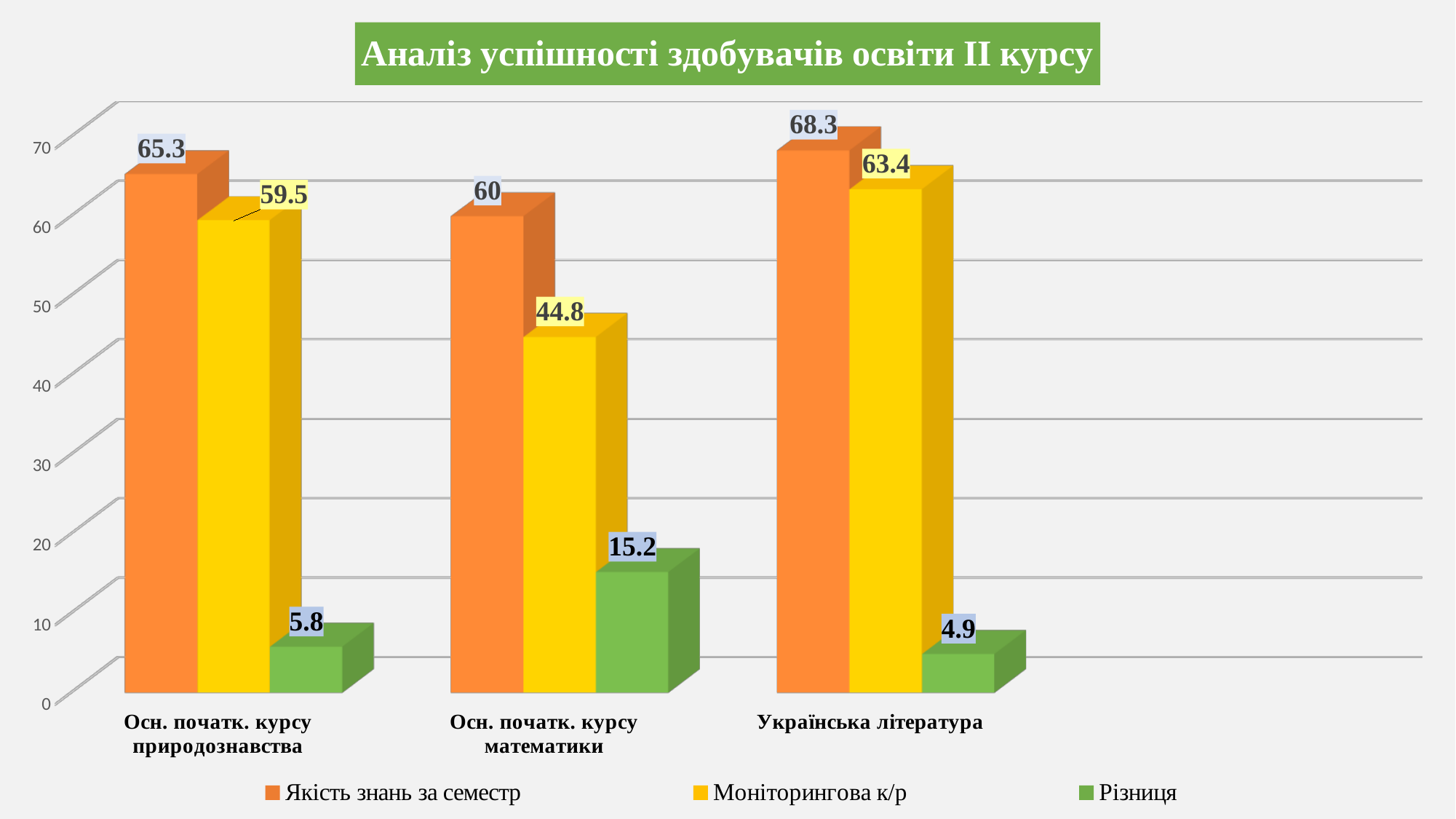
Is the value of "Різниця" for "Осн. початк. курсу математики" greater or less than 10? greater What is the value of "Якість знань за семестр" for "Українська література"? 68.3 Which category has the lowest value for "Моніторингова к/р"? Осн. початк. курсу математики What is the difference between "Якість знань за семестр" and "Моніторингова к/р" for "Осн. початк. курсу математики"? 15.2 What is the value of "Моніторингова к/р" for "Осн. початк. курсу математики"? 44.8 How many categories are shown on the x axis? 3 What is the title of the chart? Аналіз успішності здобувачів освіти ІІ курсу Which category has the highest value for "Якість знань за семестр"? Українська література Which is larger: "Моніторингова к/р" for "Осн. початк. курсу природознавства" or for "Українська література"? Українська література How many series does the legend list? 3 What is the value of "Різниця" for "Осн. початк. курсу природознавства"? 5.8 What kind of chart is shown on the slide? bar chart